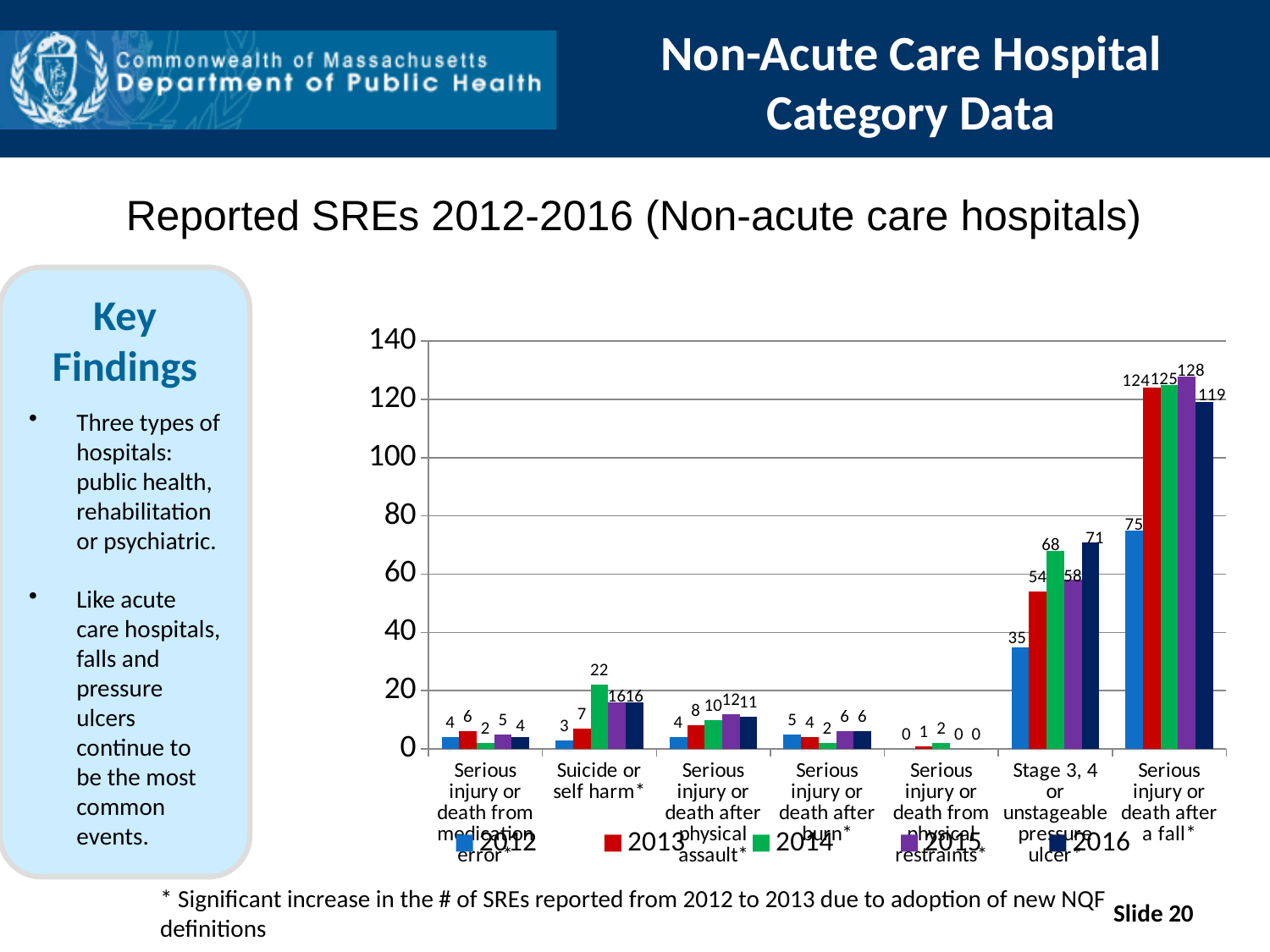
What type of chart is shown on the slide? Bar chart What is the value for 2014 in the 'Suicide or self harm*' category? 22 Which year has the highest value in the 'Serious injury or death after a fall*' category? 2015 Is the 2013 value for 'Serious injury or death after a fall*' greater or less than 100? greater Which is larger: the 2014 value for 'Suicide or self harm*' or the 2015 value for 'Serious injury or death after physical assault*'? 2014 value for Suicide or self harm* How many categories are shown on the x axis? 7 Which year has the lowest value in the 'Stage 3, 4 or unstageable pressure ulcer' category? 2012 What is the value for 2016 in the 'Serious injury or death after a fall*' category? 119 How many series does the legend list? 5 What is the value for 2012 in the 'Stage 3, 4 or unstageable pressure ulcer' category? 35 What is the difference between the 2016 and 2012 values for 'Stage 3, 4 or unstageable pressure ulcer'? 36 What is the title of the chart? Reported SREs 2012-2016 (Non-acute care hospitals)